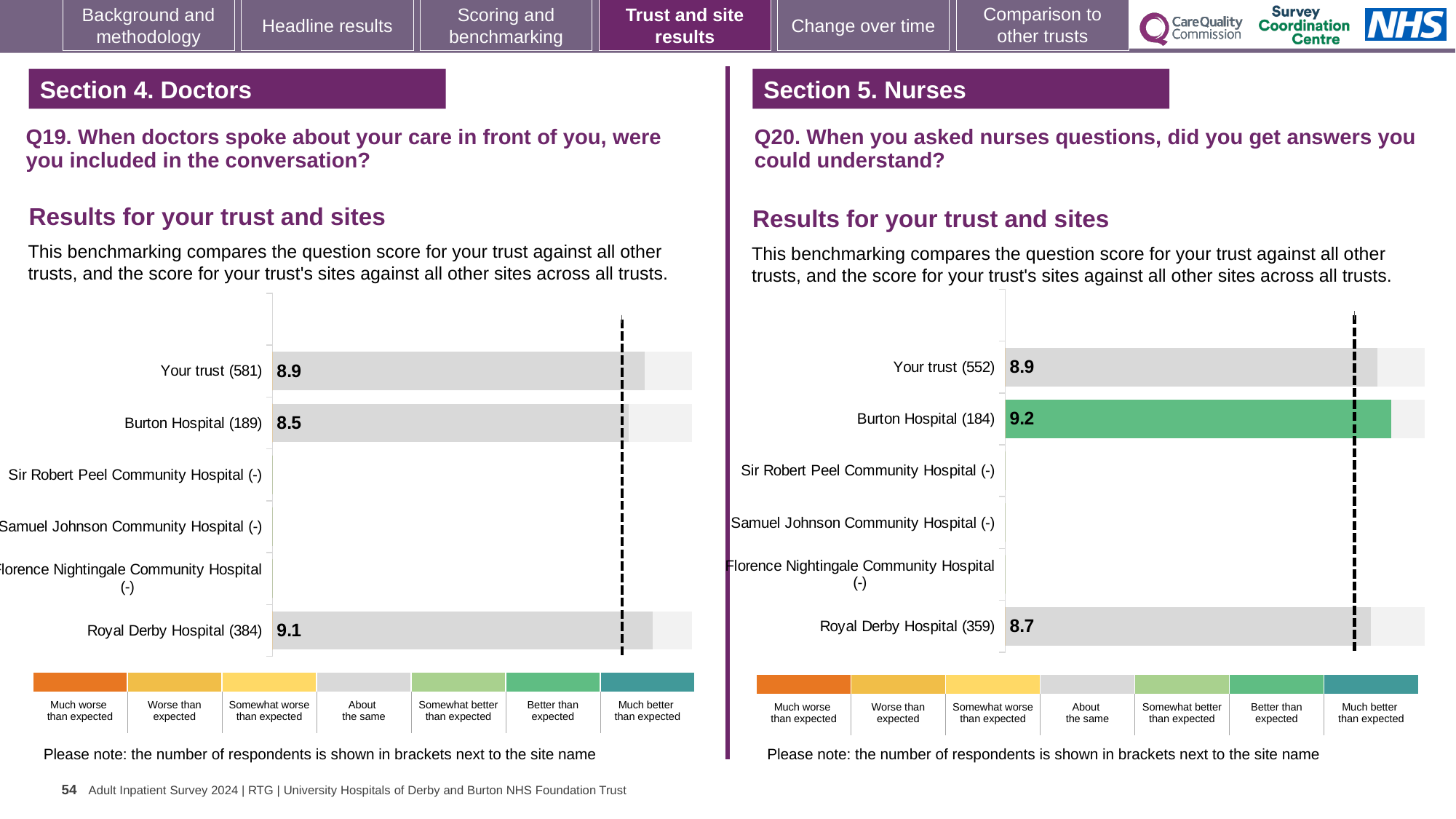
In the Q19 chart on the left, what is the score for Your trust (581)? 8.9 In the Q20 chart on the right, which bar is coloured green rather than grey? Burton Hospital (184) In the Q20 chart on the right, what is the difference between the scores for Burton Hospital and Your trust? 0.3 In the Q20 chart on the right, what is the score for Burton Hospital (184)? 9.2 In the Q19 chart on the left, what is the score for Royal Derby Hospital (384)? 9.1 In the Q19 chart on the left, what is the difference between the scores for Royal Derby Hospital and Burton Hospital? 0.6 What kind of chart is used in the Q19 chart on the left? Bar chart In the Q19 chart on the left, what is the score for Burton Hospital (189)? 8.5 In the Q20 chart on the right, which is larger: the score for Burton Hospital or the score for Your trust? Burton Hospital In the Q19 chart on the left, which site has the highest score? Royal Derby Hospital (384) In the Q20 chart on the right, what is the score for Royal Derby Hospital (359)? 8.7 In the Q20 chart on the right, which site has the lowest score among those with a score shown? Royal Derby Hospital (359)